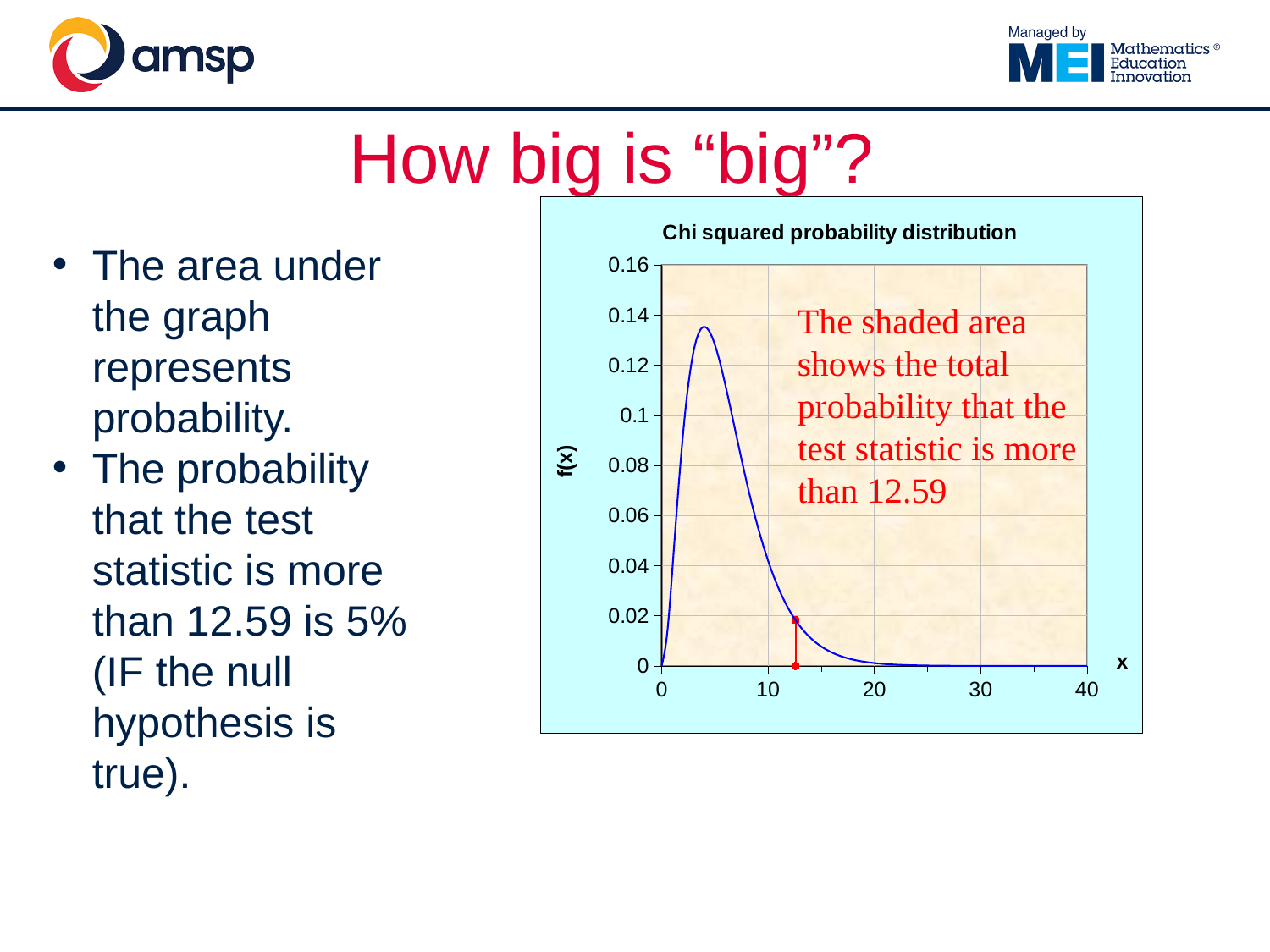
Is the value of f(x) at x = 30 greater or less than 0.02? less What is the label on the vertical axis of the chart? f(x) According to the annotation on the chart, the shaded area shows the probability that the test statistic is more than what value? 12.59 Does the curve rise or fall as x increases from 10 to 40? fall What is the title of the chart? Chi squared probability distribution Is the value of f(x) at x = 20 greater or less than 0.02? less Is the peak value of the curve greater or less than 0.12? greater What is the highest value shown on the x axis? 40 How many labelled tick marks are there on the x axis? 5 What kind of chart is shown on the slide? line chart Which is larger, the value of f(x) at x = 10 or at x = 20? x = 10